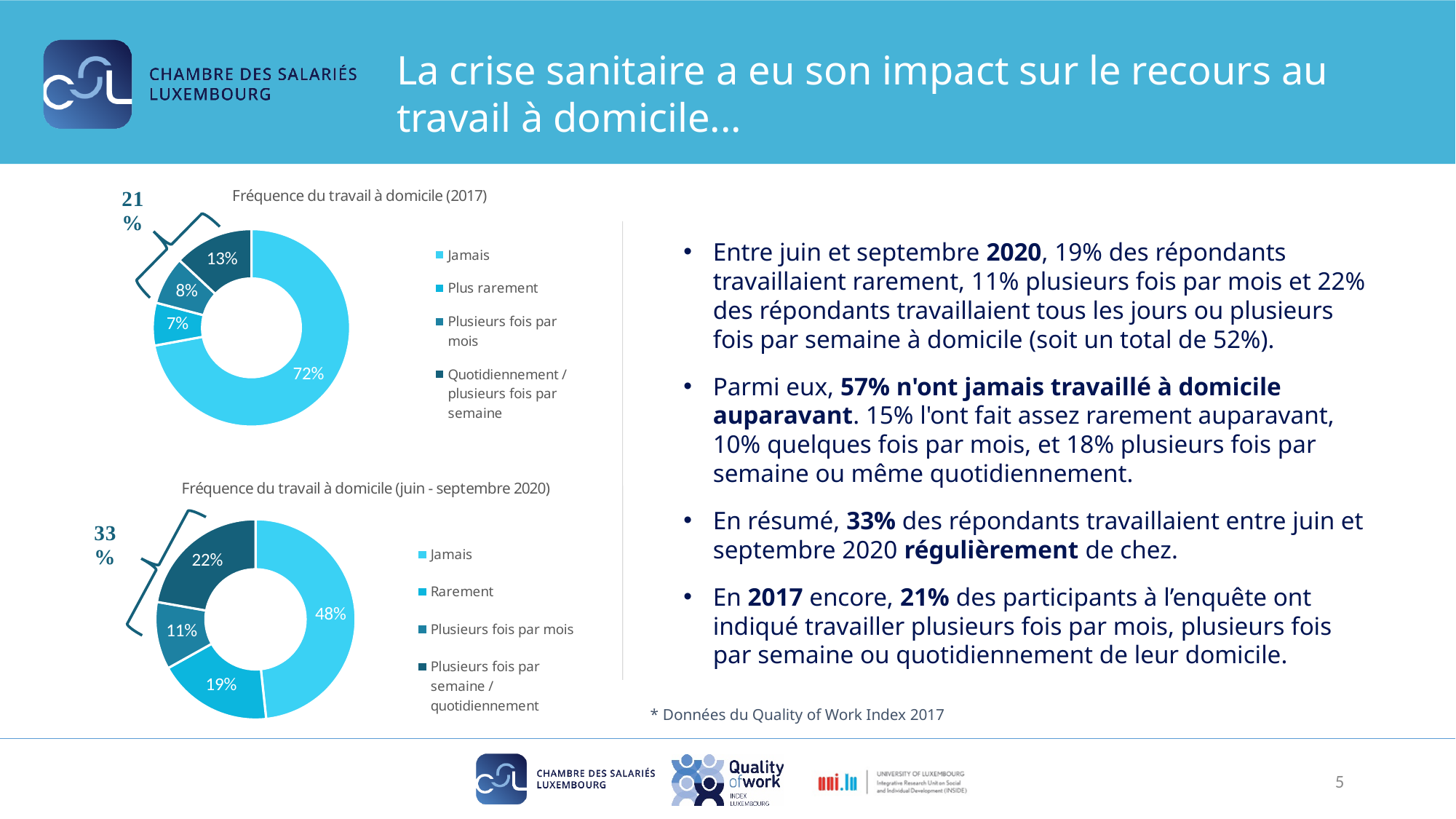
What is the title of the lower chart on the slide? Fréquence du travail à domicile (juin - septembre 2020) In the 'Fréquence du travail à domicile (2017)' chart, which category has the smallest share? Plus rarement In the 'Fréquence du travail à domicile (2017)' chart, what is the combined share of 'Plusieurs fois par mois' and 'Quotidiennement / plusieurs fois par semaine'? 21% How many categories does the 'Fréquence du travail à domicile (2017)' chart show? 4 In the 'Fréquence du travail à domicile (juin - septembre 2020)' chart, which is larger: 'Plusieurs fois par mois' or 'Plusieurs fois par semaine / quotidiennement'? Plusieurs fois par semaine / quotidiennement In the 'Fréquence du travail à domicile (2017)' chart, what share of respondents answered 'Jamais'? 72% In the 'Fréquence du travail à domicile (juin - septembre 2020)' chart, which category has the largest share? Jamais What is the difference between the 'Jamais' share in the 2017 chart and the 'Jamais' share in the juin - septembre 2020 chart? 24 percentage points In the 'Fréquence du travail à domicile (2017)' chart, what is the value for 'Quotidiennement / plusieurs fois par semaine'? 13% In the 'Fréquence du travail à domicile (juin - septembre 2020)' chart, what is the value for 'Rarement'? 19% What type of chart is used for 'Fréquence du travail à domicile (juin - septembre 2020)'? Donut (pie) chart In the 'Fréquence du travail à domicile (juin - septembre 2020)' chart, what is the value for 'Plusieurs fois par semaine / quotidiennement'? 22%